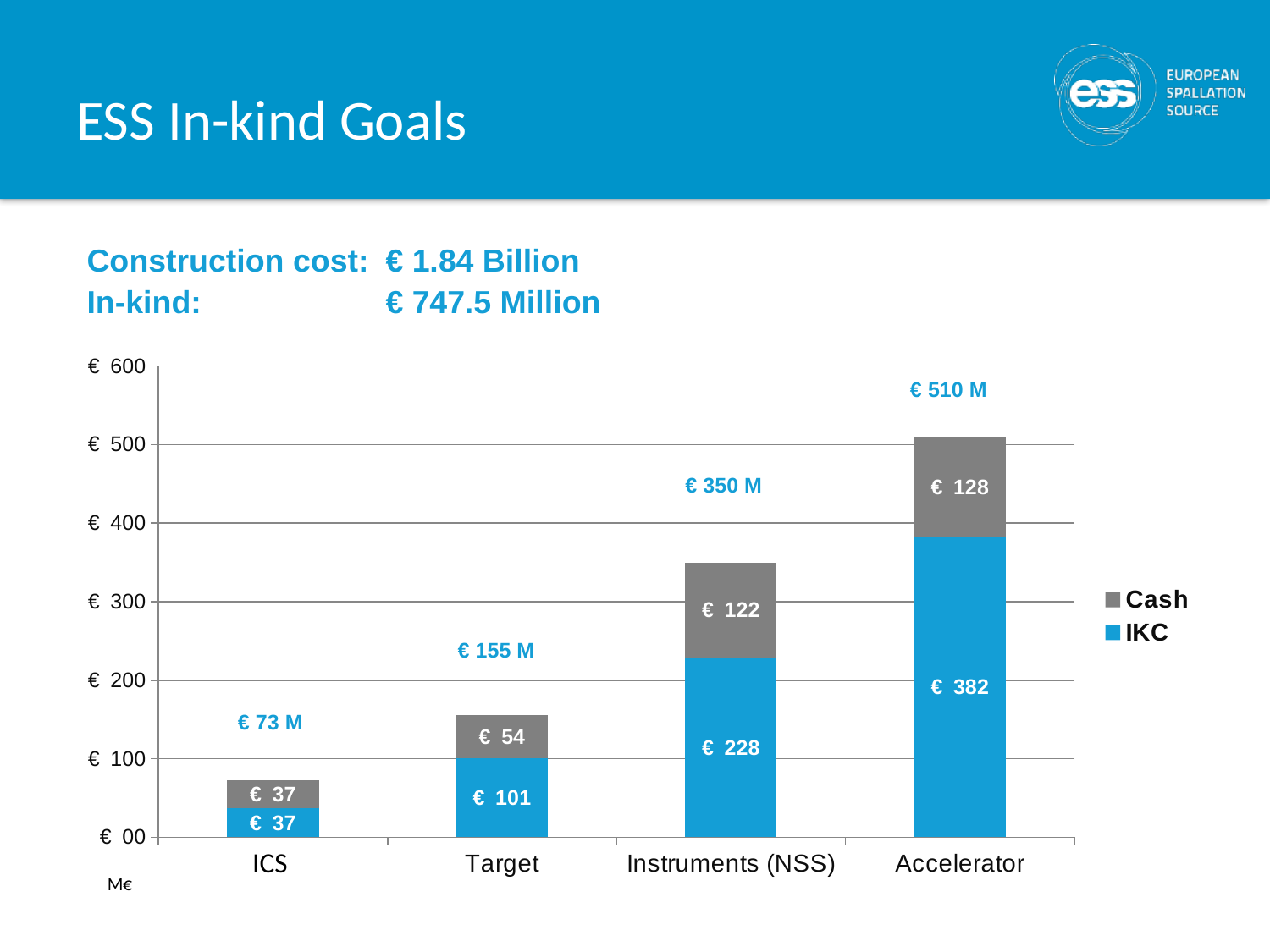
What kind of chart is shown? Stacked bar chart Which category has the lowest total? ICS What is the difference between the IKC values for Accelerator and Instruments (NSS)? € 154 Which is larger, the Cash value for Target or the Cash value for Instruments (NSS)? Instruments (NSS) What is the Cash value for Instruments (NSS)? € 122 Which series is shown in grey in the legend? Cash What is the IKC value for Target? € 101 How many categories are shown on the x axis? 4 What is the IKC value for Accelerator? € 382 What is the total labelled above the ICS bar? € 73 M How many series does the legend list? 2 Which category has the highest total? Accelerator